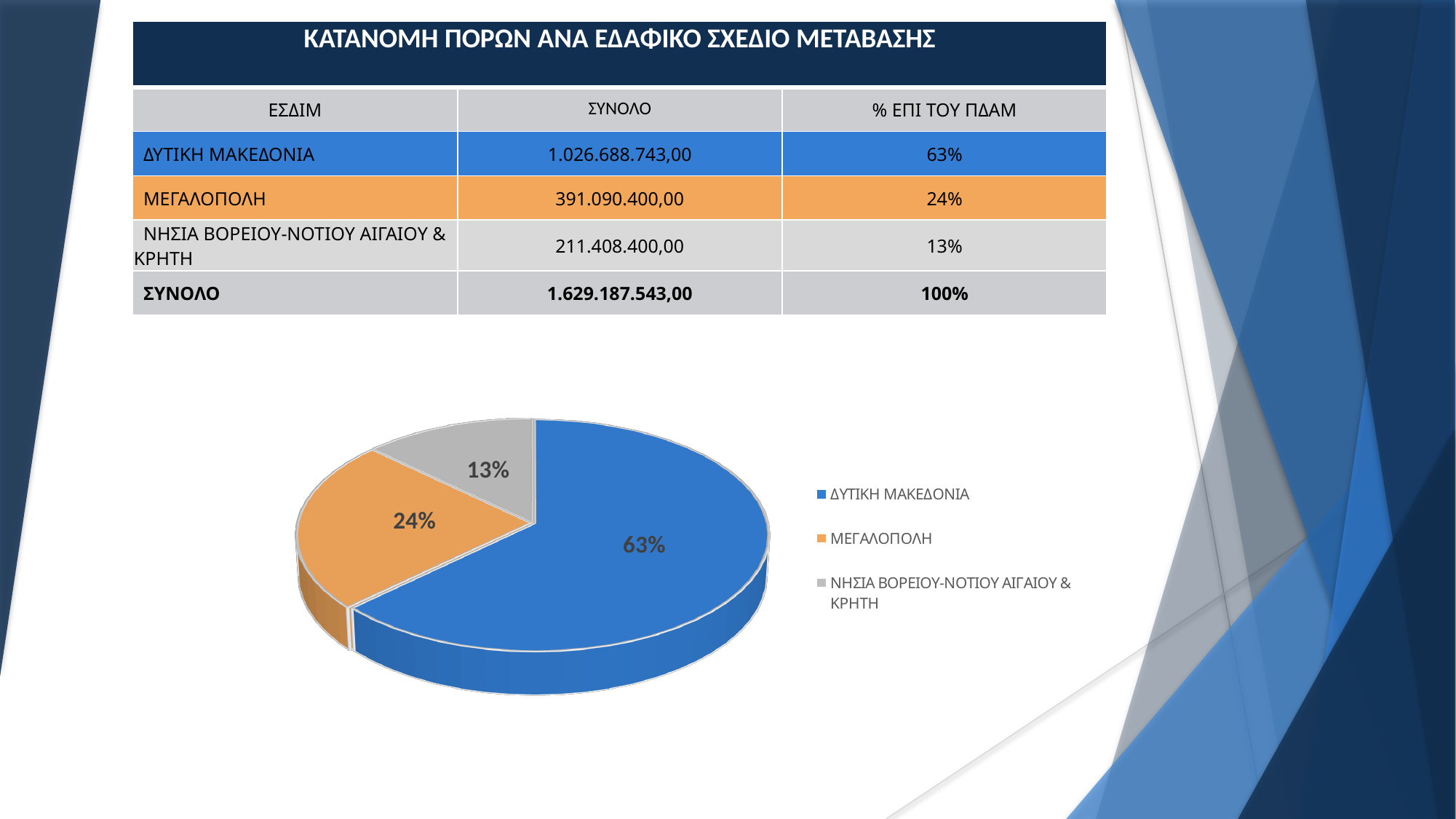
How many slices does the pie chart have? 3 What kind of chart is shown on the slide? pie chart Which slice of the pie chart is the smallest? ΝΗΣΙΑ ΒΟΡΕΙΟΥ-ΝΟΤΙΟΥ ΑΙΓΑΙΟΥ & ΚΡΗΤΗ What colour is the ΔΥΤΙΚΗ ΜΑΚΕΔΟΝΙΑ slice in the pie chart? blue In the pie chart, what share is shown for ΔΥΤΙΚΗ ΜΑΚΕΔΟΝΙΑ? 63% In the pie chart, what share is shown for ΜΕΓΑΛΟΠΟΛΗ? 24% In the pie chart, what is the difference in percentage points between the ΔΥΤΙΚΗ ΜΑΚΕΔΟΝΙΑ slice and the ΜΕΓΑΛΟΠΟΛΗ slice? 39 percentage points Which slice of the pie chart is the largest? ΔΥΤΙΚΗ ΜΑΚΕΔΟΝΙΑ In the pie chart, which slice is larger: ΜΕΓΑΛΟΠΟΛΗ or ΝΗΣΙΑ ΒΟΡΕΙΟΥ-ΝΟΤΙΟΥ ΑΙΓΑΙΟΥ & ΚΡΗΤΗ? ΜΕΓΑΛΟΠΟΛΗ In the pie chart, what share is shown for ΝΗΣΙΑ ΒΟΡΕΙΟΥ-ΝΟΤΙΟΥ ΑΙΓΑΙΟΥ & ΚΡΗΤΗ? 13% What colour is the ΜΕΓΑΛΟΠΟΛΗ slice in the pie chart? orange How many entries does the pie chart legend list? 3